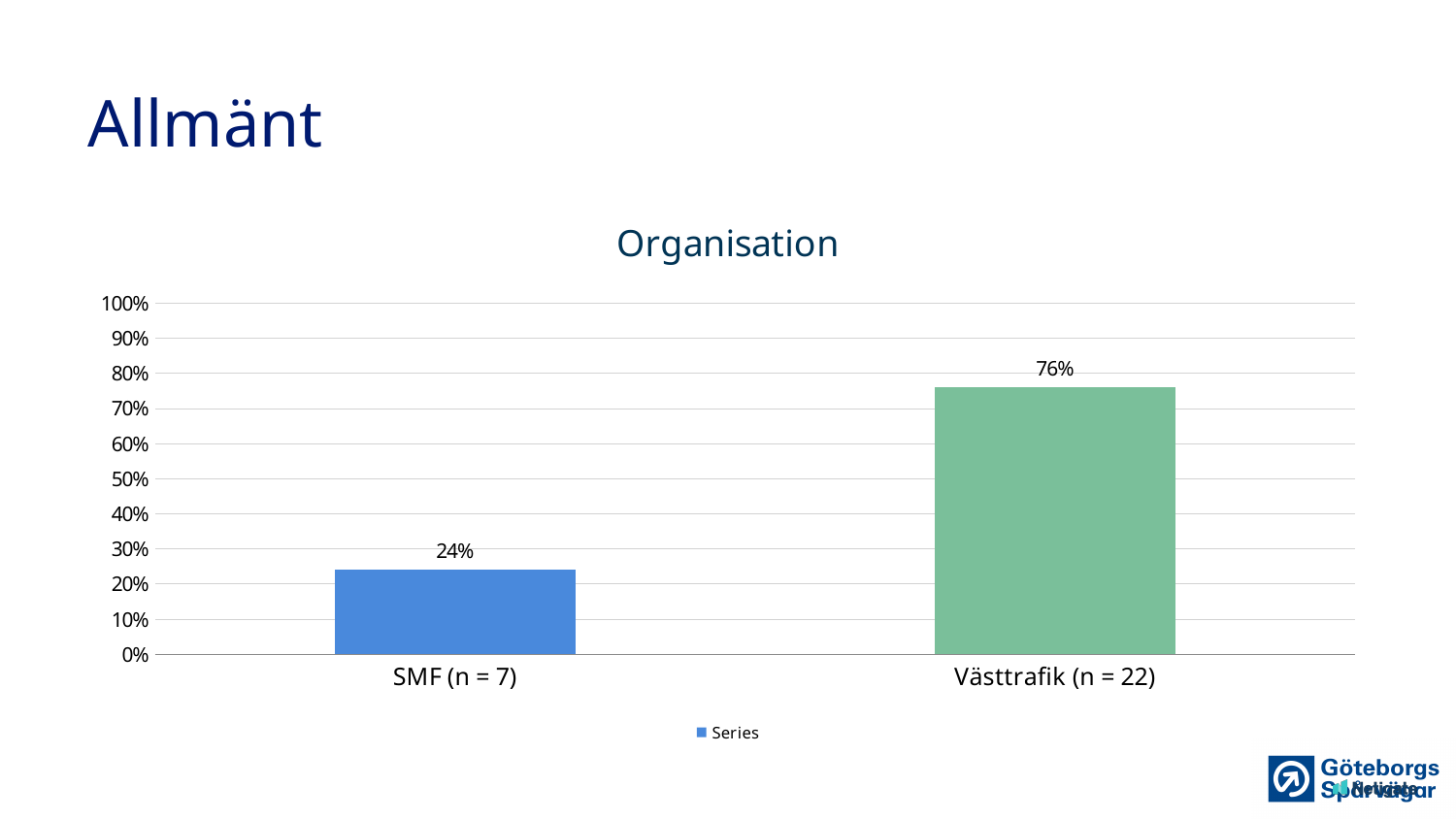
How many categories are shown on the x axis? 2 Is the value for Västtrafik (n = 22) greater or less than 50%? greater Is the value for SMF (n = 7) greater or less than 30%? less What kind of chart is shown on the slide? bar chart Which category has the highest value? Västtrafik (n = 22) Which category has the lowest value? SMF (n = 7) What is the difference between the values for Västtrafik (n = 22) and SMF (n = 7)? 52% Which is larger, the value for SMF (n = 7) or the value for Västtrafik (n = 22)? Västtrafik (n = 22) What is the value for SMF (n = 7)? 24% How many series does the legend list? 1 What is the title of the chart? Organisation What is the value for Västtrafik (n = 22)? 76%